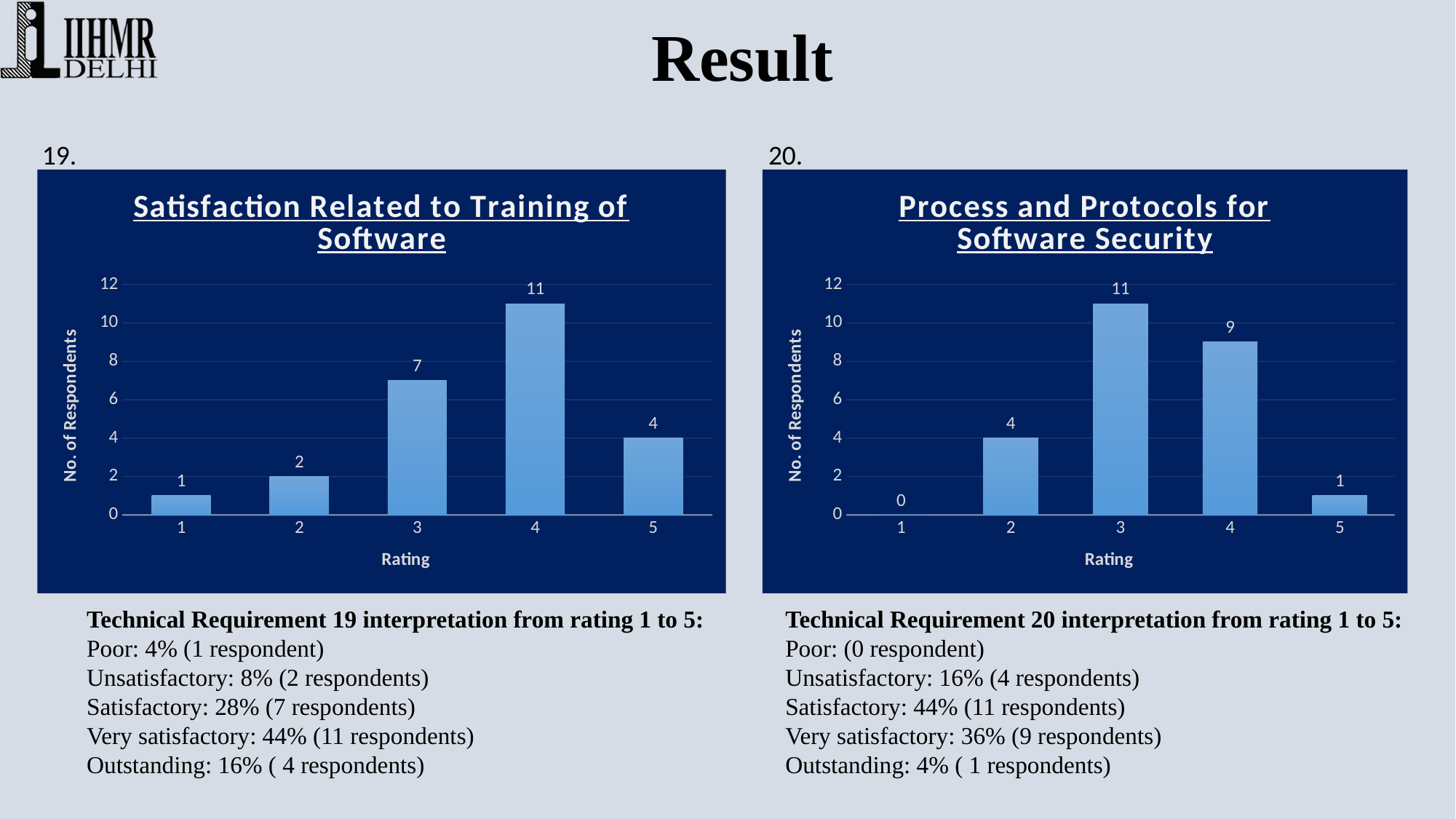
How many rating categories are shown on the x axis of the 'Process and Protocols for Software Security' chart? 5 In the 'Process and Protocols for Software Security' chart, how many respondents gave a rating of 2? 4 In the 'Satisfaction Related to Training of Software' chart, do the values rise or fall from rating 1 to rating 4? Rise In the 'Process and Protocols for Software Security' chart, which has more respondents: rating 3 or rating 4? Rating 3 In the 'Satisfaction Related to Training of Software' chart, is the value for rating 5 greater or less than 6? less In the 'Satisfaction Related to Training of Software' chart, how many respondents gave a rating of 4? 11 In the 'Satisfaction Related to Training of Software' chart, what is the difference in respondents between rating 4 and rating 3? 4 What is the y-axis label of the 'Process and Protocols for Software Security' chart? No. of Respondents In the 'Process and Protocols for Software Security' chart, what is the difference in respondents between rating 3 and rating 5? 10 In the 'Process and Protocols for Software Security' chart, which rating has the lowest number of respondents? 1 What type of chart is the 'Satisfaction Related to Training of Software' chart? Bar chart In the 'Satisfaction Related to Training of Software' chart, which rating has the highest number of respondents? 4